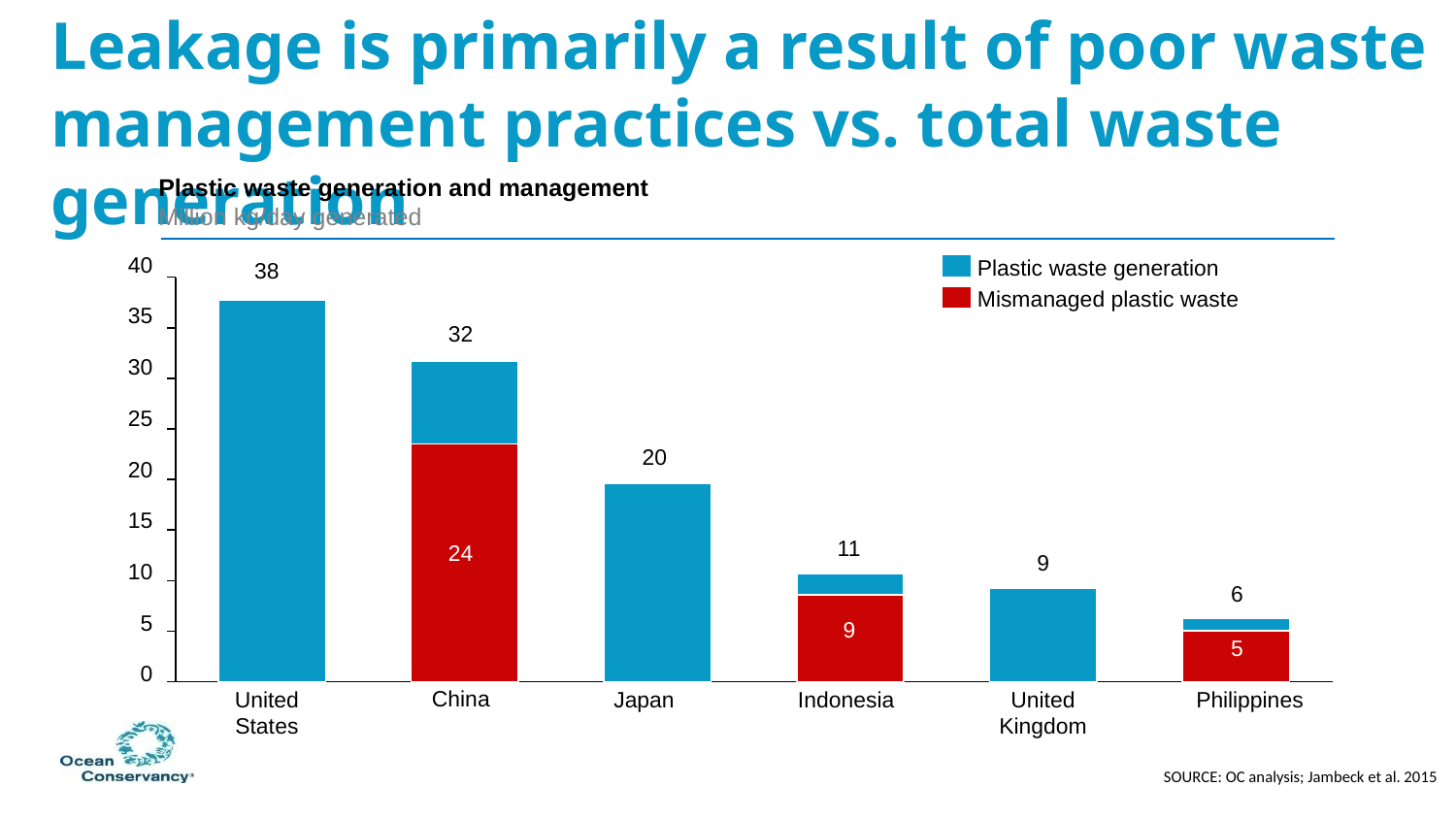
How many series does the legend list? 2 Which is larger, plastic waste generation in Japan or in the United Kingdom? Japan How many countries are shown on the x axis? 6 What kind of chart is shown on the slide? bar chart What is the mismanaged plastic waste value for the Philippines? 5 Which country has the lowest plastic waste generation? Philippines What is the difference between plastic waste generation in the United States and in China? 6 What is the plastic waste generation value for the United States? 38 What is the difference between China's plastic waste generation and its mismanaged plastic waste? 8 Which country has the highest plastic waste generation? United States What is the mismanaged plastic waste value for China? 24 What is the plastic waste generation value for Indonesia? 11